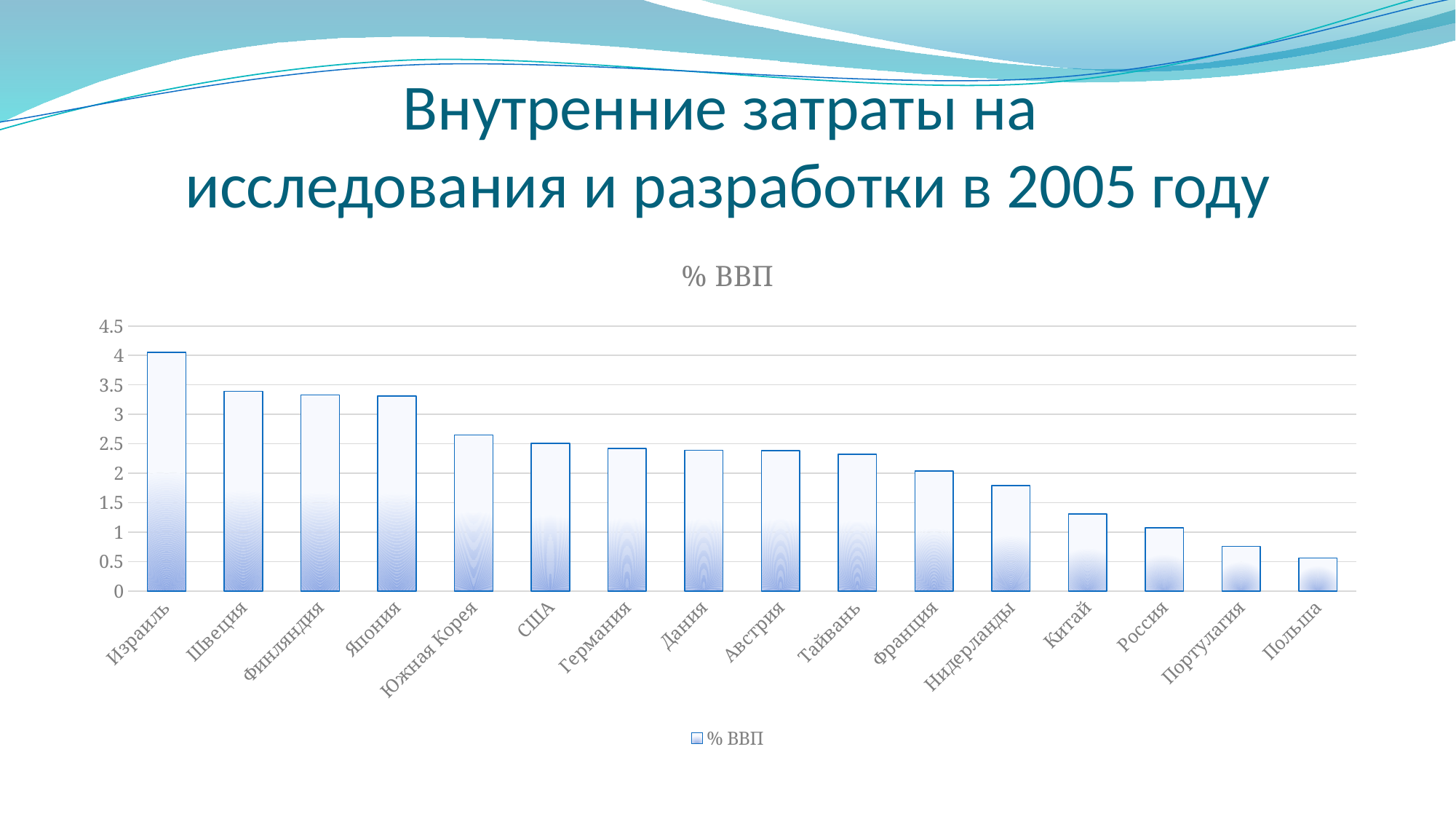
Is the value for Польша greater or less than 1? less What is the title shown above the chart? % ВВП Do the values rise or fall moving from left to right along the x axis? fall Which country has the highest value in the chart? Израиль What kind of chart is shown on the slide? bar chart Which country has the lowest value in the chart? Польша How many countries are shown on the x axis of the chart? 16 Which has the larger value, Япония or Южная Корея? Япония Is the value for Швеция greater or less than 3? greater Is the value for Китай greater or less than 1.5? less How many series does the legend list? 1